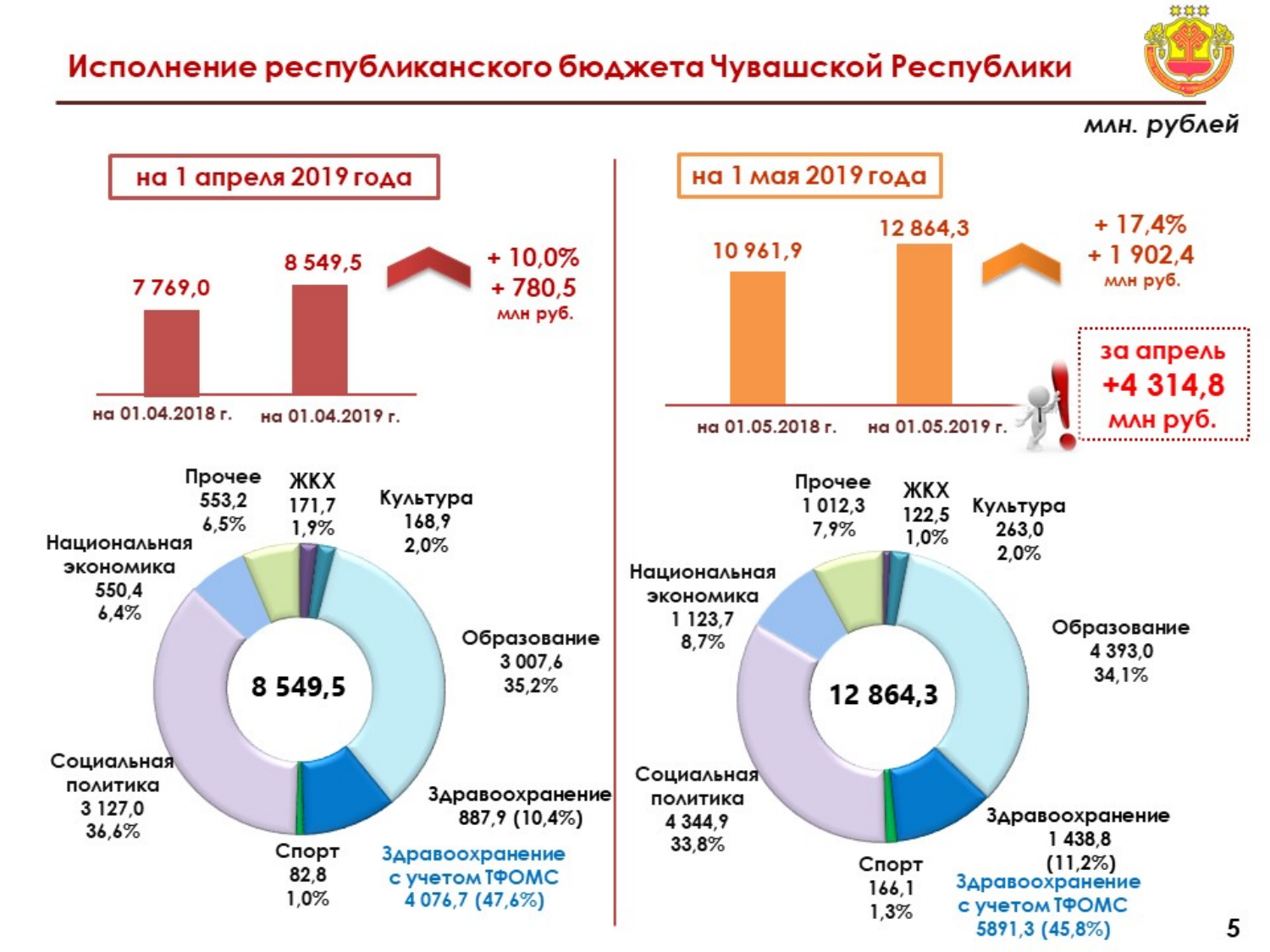
In the right donut chart (total 12 864,3), which category has the largest value? Образование In the bar chart under 'на 1 апреля 2019 года', what is the value for 'на 01.04.2019 г.'? 8 549,5 What type of chart is shown under 'на 1 мая 2019 года' with the two orange bars? bar chart In the left donut chart (total 8 549,5), what share does 'Социальная политика' have? 36,6% In the right donut chart (total 12 864,3), what is the value for 'Национальная экономика'? 1 123,7 In the left donut chart (total 8 549,5), what is the value for 'Образование'? 3 007,6 In the right donut chart (total 12 864,3), what share does 'Здравоохранение' have? 11,2% In the bar chart under 'на 1 апреля 2019 года', what is the difference between the values for 'на 01.04.2019 г.' and 'на 01.04.2018 г.'? 780,5 In the bar chart under 'на 1 мая 2019 года', what is the value for 'на 01.05.2018 г.'? 10 961,9 In the bar chart under 'на 1 мая 2019 года', which bar is higher: 'на 01.05.2018 г.' or 'на 01.05.2019 г.'? на 01.05.2019 г. How many categories are shown in the right donut chart (total 12 864,3)? 8 In the left donut chart (total 8 549,5), which category has the smallest value? Спорт